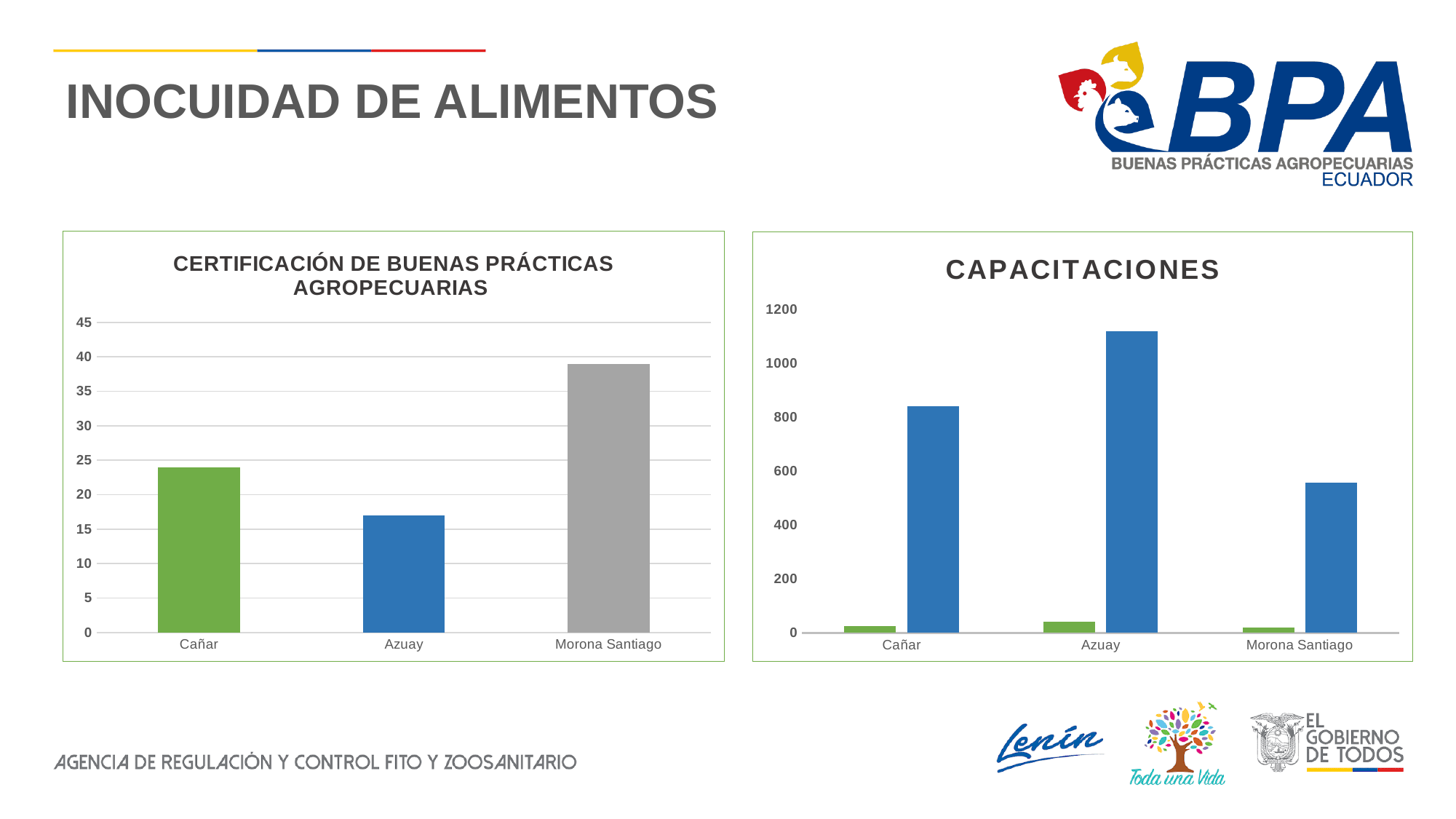
In the chart titled CAPACITACIONES, is the taller (blue) bar for Azuay greater or less than 1000? greater In the chart titled CAPACITACIONES, how many categories are shown on the x axis? 3 In the chart titled CERTIFICACIÓN DE BUENAS PRÁCTICAS AGROPECUARIAS, which category has the lowest value? Azuay In the chart titled CERTIFICACIÓN DE BUENAS PRÁCTICAS AGROPECUARIAS, is the value for Morona Santiago greater or less than 35? greater What is the title of the chart on the right side of the slide? CAPACITACIONES In the chart titled CERTIFICACIÓN DE BUENAS PRÁCTICAS AGROPECUARIAS, what kind of chart is shown? bar chart In the chart titled CERTIFICACIÓN DE BUENAS PRÁCTICAS AGROPECUARIAS, how many categories are shown on the x axis? 3 In the chart titled CERTIFICACIÓN DE BUENAS PRÁCTICAS AGROPECUARIAS, which is larger, the value for Cañar or the value for Azuay? Cañar In the chart titled CERTIFICACIÓN DE BUENAS PRÁCTICAS AGROPECUARIAS, which category has the highest value? Morona Santiago In the chart titled CAPACITACIONES, which category has the tallest bar? Azuay In the chart titled CERTIFICACIÓN DE BUENAS PRÁCTICAS AGROPECUARIAS, is the value for Azuay greater or less than 20? less